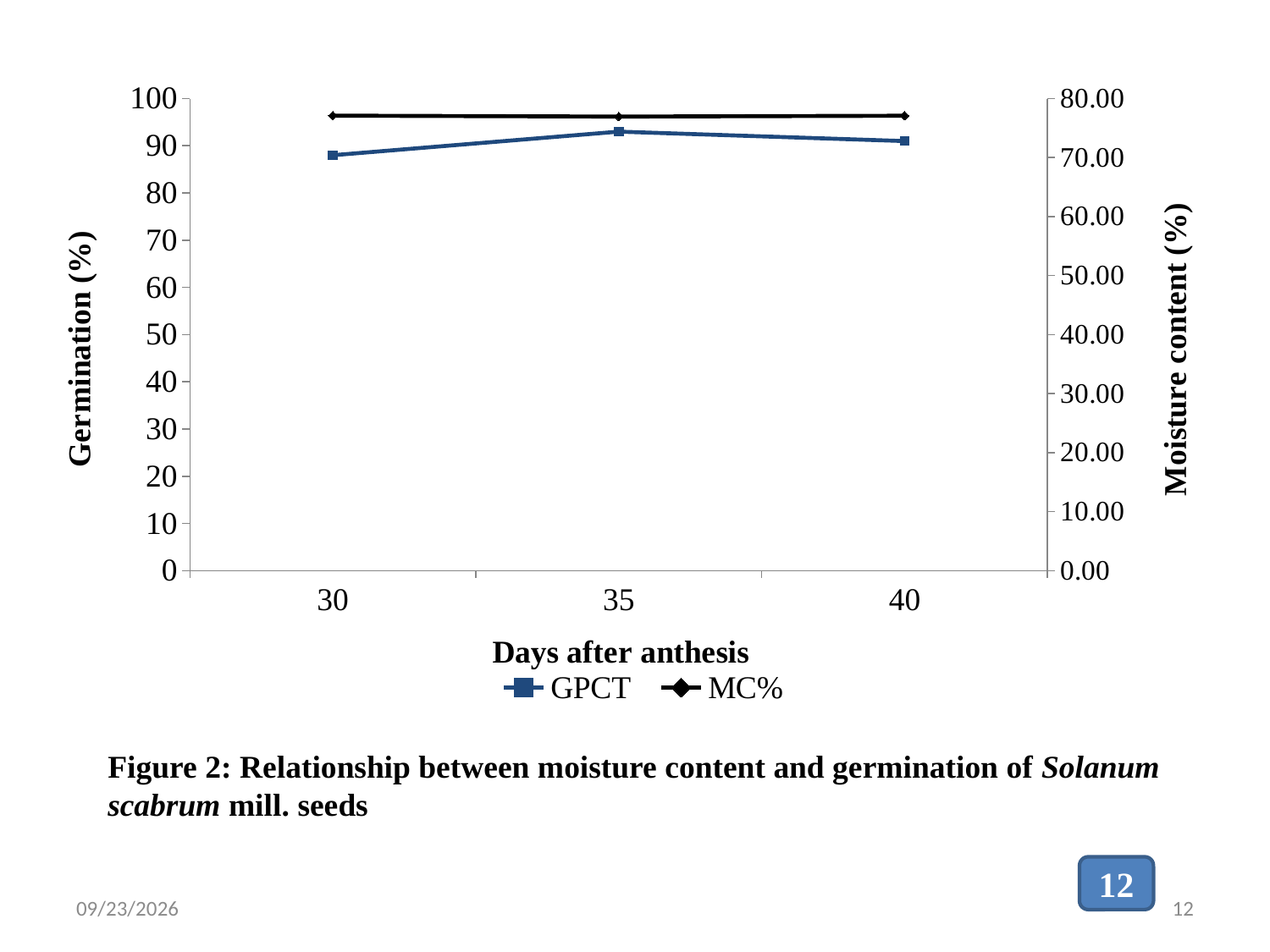
How many points on the x axis (days after anthesis) are plotted? 3 How many series does the legend list? 2 At which number of days after anthesis is the GPCT value lowest? 30 What is the title of the x axis? Days after anthesis What is the title of the right-hand y axis? Moisture content (%) Is the GPCT value at 35 days after anthesis greater or less than 90? greater Is the GPCT value at 30 days after anthesis greater or less than 80? greater Is the MC% value at 30 days after anthesis greater or less than 70.00? greater Does the GPCT value rise or fall from 30 to 35 days after anthesis? rise What kind of chart is shown on the slide? line chart At which number of days after anthesis is the GPCT value highest? 35